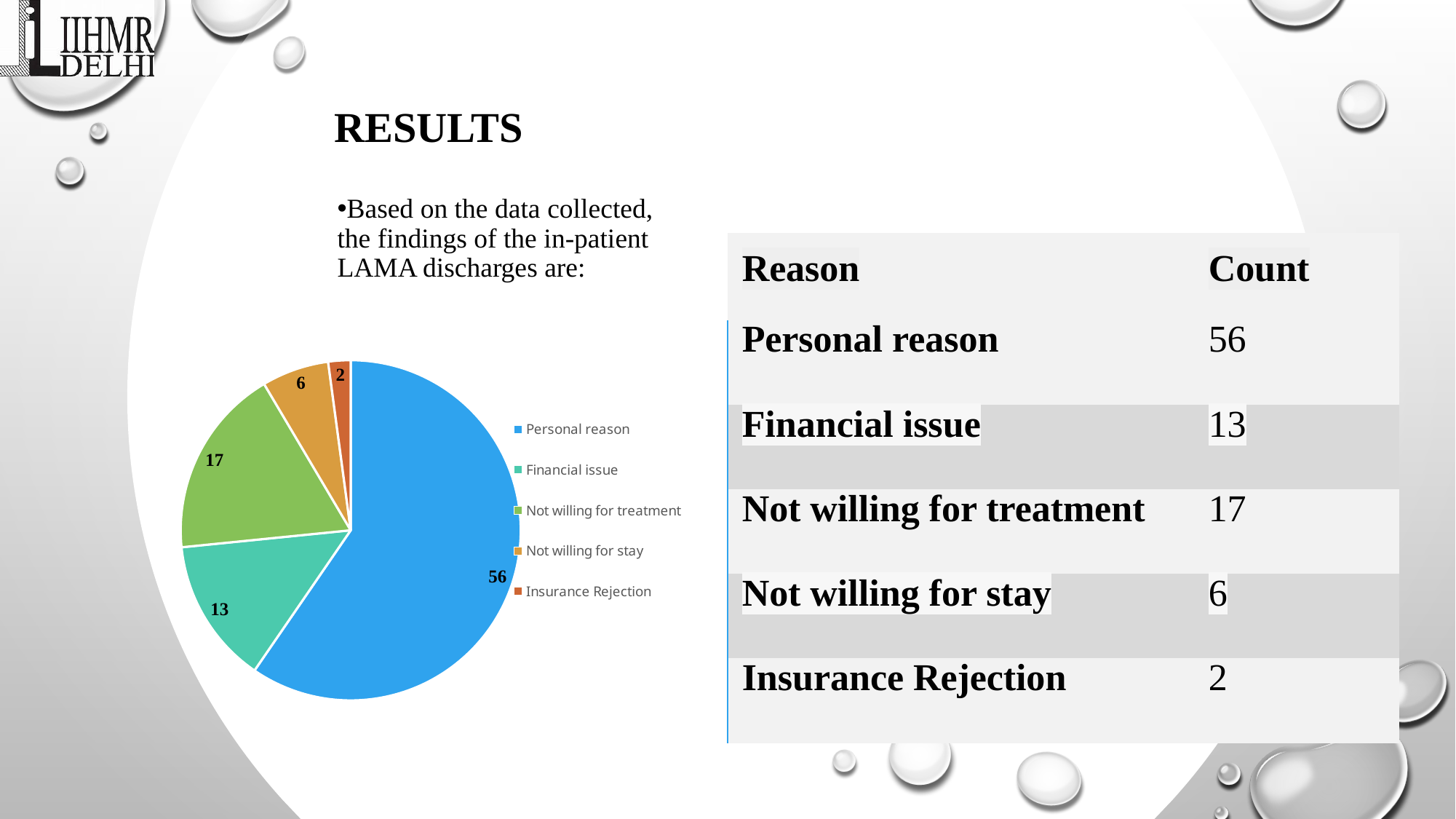
What is the difference between the values for Personal reason and Financial issue? 43 What is the value for Not willing for stay in the pie chart? 6 What is the value for Personal reason in the pie chart? 56 Which category has the smallest slice in the pie chart? Insurance Rejection What is the difference between the values for Not willing for treatment and Not willing for stay? 11 Which is larger, Financial issue or Not willing for treatment? Not willing for treatment Which category has the largest slice in the pie chart? Personal reason What type of chart is shown on the slide? Pie chart What is the value for Not willing for treatment in the pie chart? 17 What colour is the Personal reason slice in the pie chart? Blue What is the value for Insurance Rejection in the pie chart? 2 How many categories does the pie chart show? 5